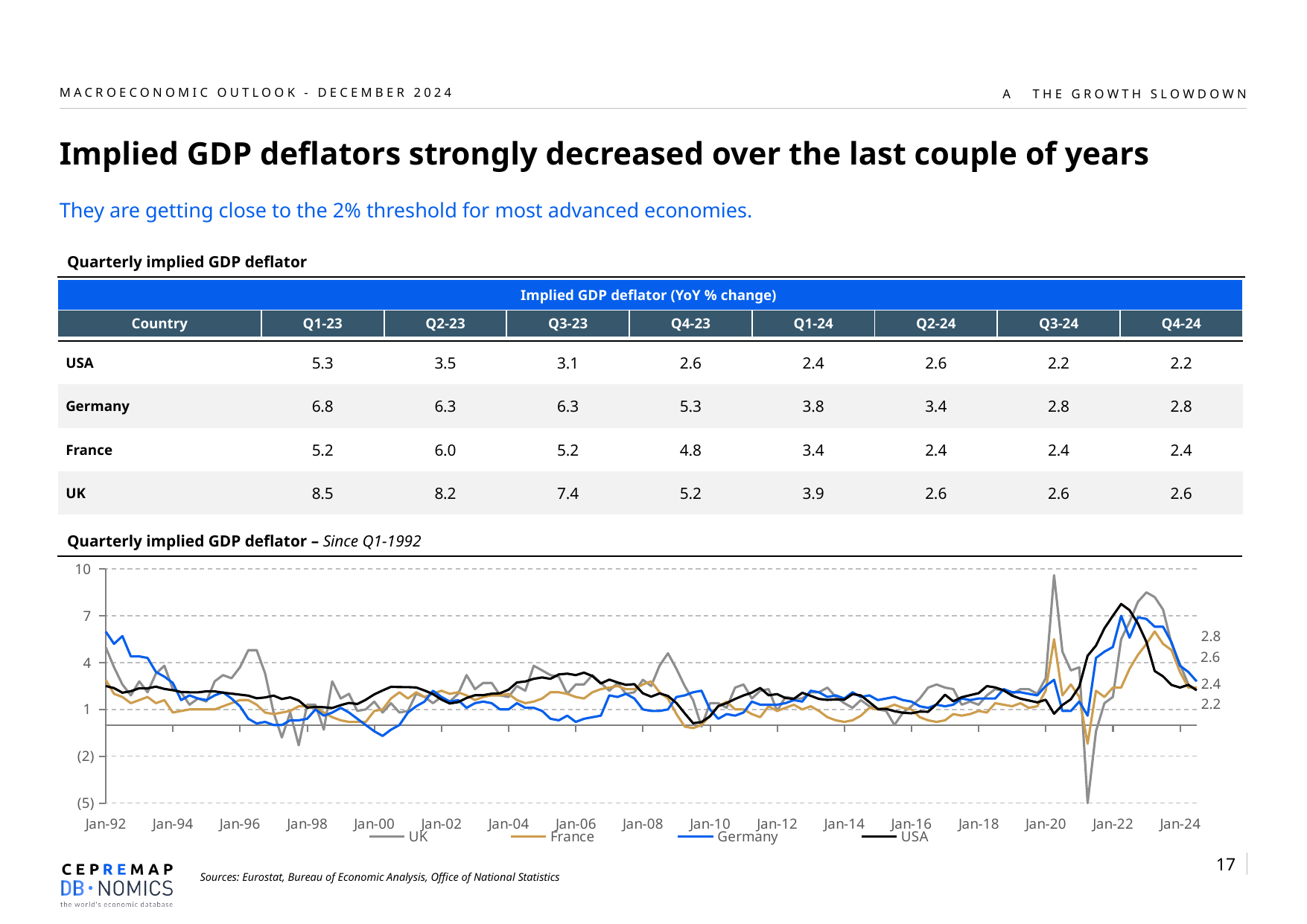
In the line chart, what is the first date label on the horizontal axis? Jan-92 In the line chart, what is the lowest value shown on the vertical axis? (5) In the line chart, which colour is used for the USA series? black How many series does the legend of the line chart list? 4 What kind of chart is the 'Quarterly implied GDP deflator – Since Q1-1992' chart? line chart Which countries are listed in the legend of the line chart? UK, France, Germany, USA In the line chart, is the Germany value at Jan-92 greater or less than 4? greater In the line chart, is the UK peak around Jan-20 greater or less than 7? greater In the line chart, is the lowest UK value around Jan-21 greater or less than (2)? less In the line chart, what is the last date label on the horizontal axis? Jan-24 In the line chart, what is the highest value shown on the vertical axis? 10